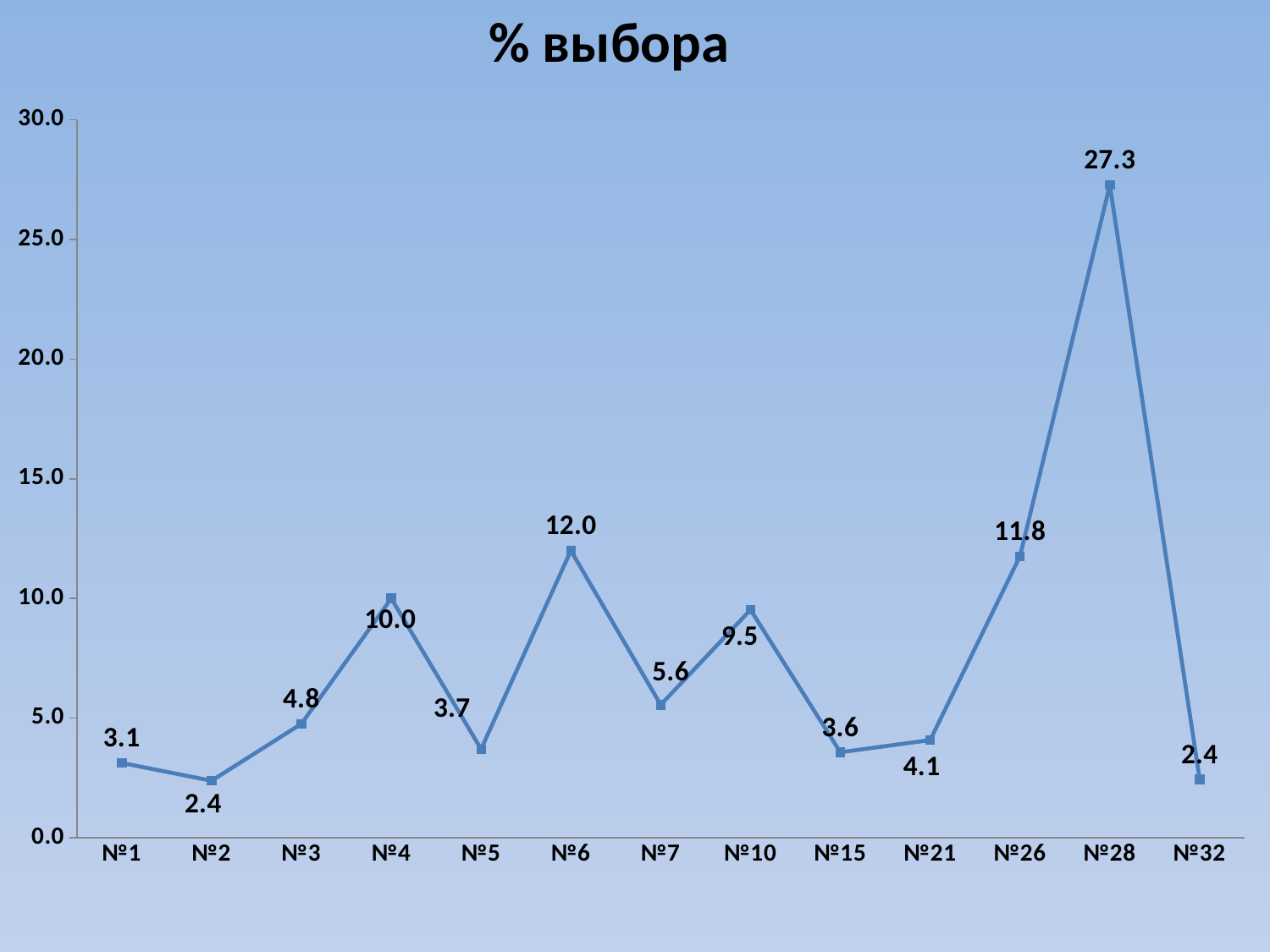
What is the title of the chart? % выбора What is the value for №21? 4.1 Which category has the highest value? №28 Which is larger, the value for №6 or the value for №26? №6 What type of chart is shown on the slide? line chart What is the value for №10? 9.5 What is the value for №28? 27.3 What is the value for №6? 12.0 What is the difference between the values for №4 and №5? 6.3 What is the difference between the values for №28 and №26? 15.5 How many categories are plotted on the x axis? 13 Is the value for №28 greater or less than 25.0? greater